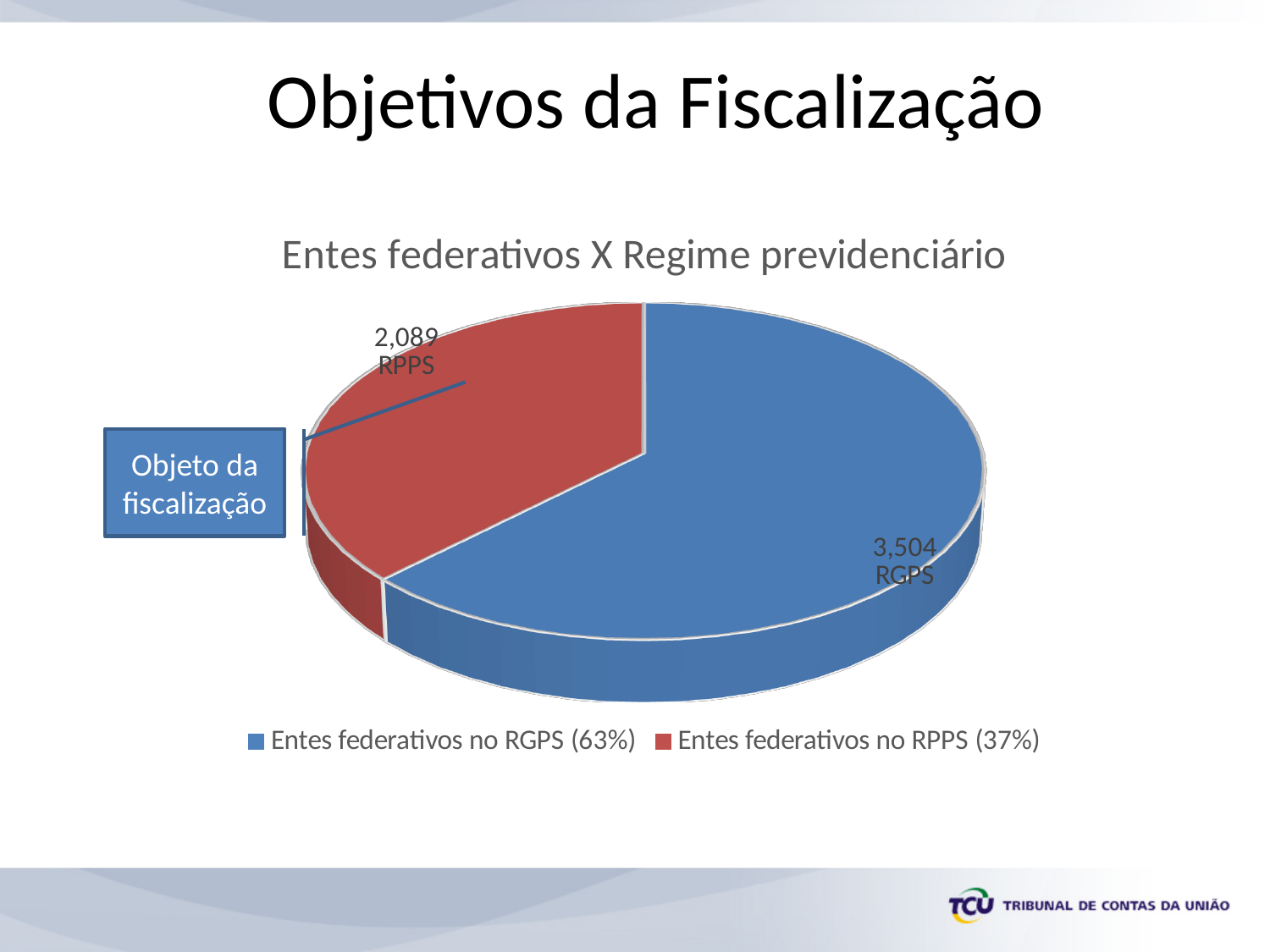
How many slices does the pie chart have? 2 Which slice is the largest? RGPS What colour is the slice for Entes federativos no RPPS? Red Which is larger, the RGPS slice or the RPPS slice? RGPS What type of chart is shown on the slide? Pie chart Which slice is the smallest? RPPS What is the value of the RGPS slice? 3,504 What is the title of the chart? Entes federativos X Regime previdenciário What share of the pie does the RPPS slice represent, according to the legend? 37% What is the difference between the RGPS and RPPS values? 1,415 What share of the pie does the RGPS slice represent, according to the legend? 63% What is the value of the RPPS slice? 2,089